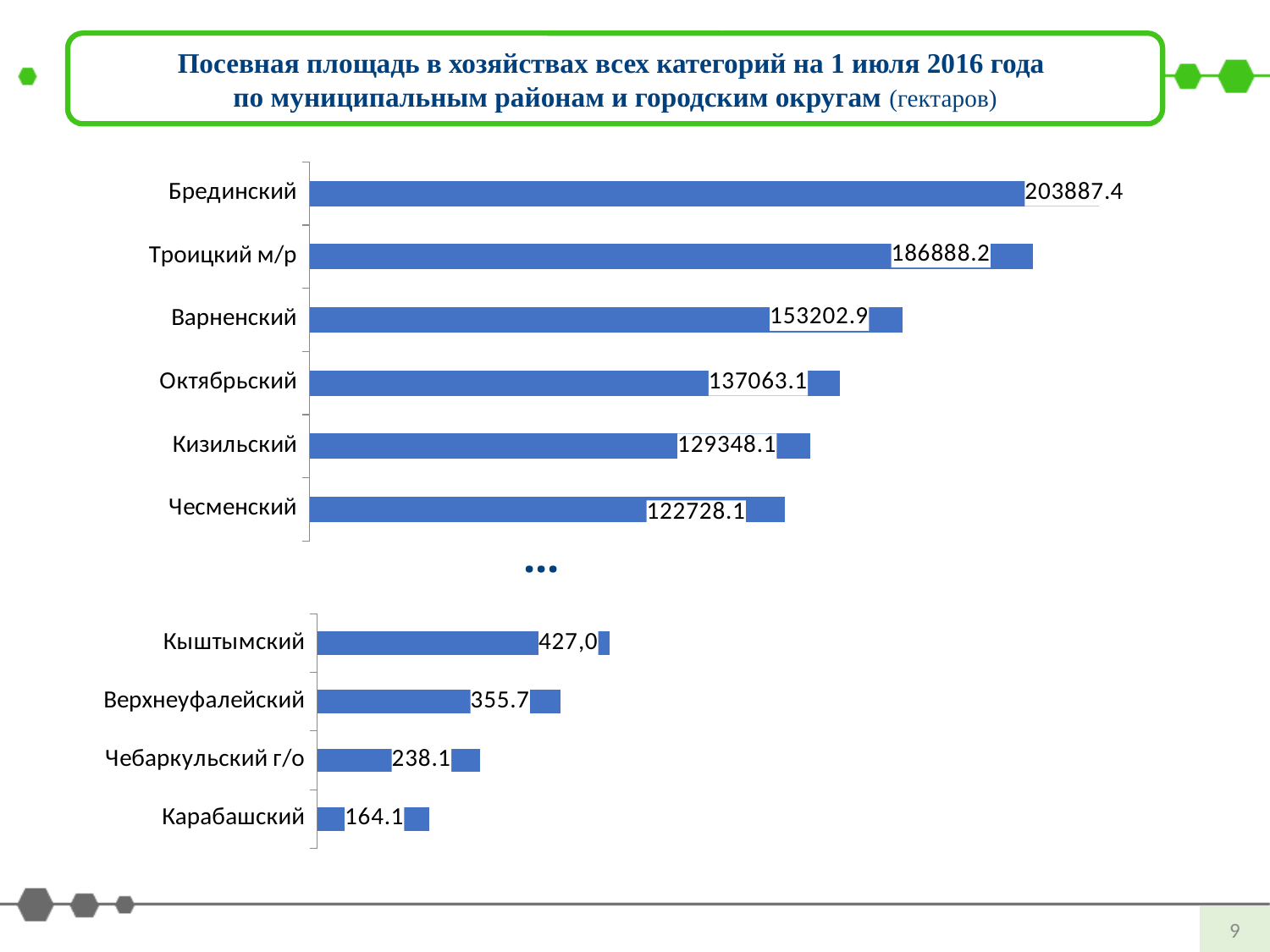
In the top chart, what is the value for Брединский? 203887.4 In the bottom chart, which category has the lowest value? Карабашский What kind of chart is the top chart? Bar chart In the top chart, what is the value for Кизильский? 129348.1 How many categories are shown in the bottom chart? 4 In the top chart, which category has the highest value? Брединский In the bottom chart, what is the value for Верхнеуфалейский? 355.7 In the top chart, which is larger: the value for Варненский or the value for Октябрьский? Варненский In the bottom chart, what is the difference between the values for Верхнеуфалейский and Чебаркульский г/о? 117.6 In the top chart, what is the difference between the values for Брединский and Троицкий м/р? 16999.2 In the top chart, which category has the lowest value? Чесменский In the bottom chart, what is the value for Кыштымский? 427,0